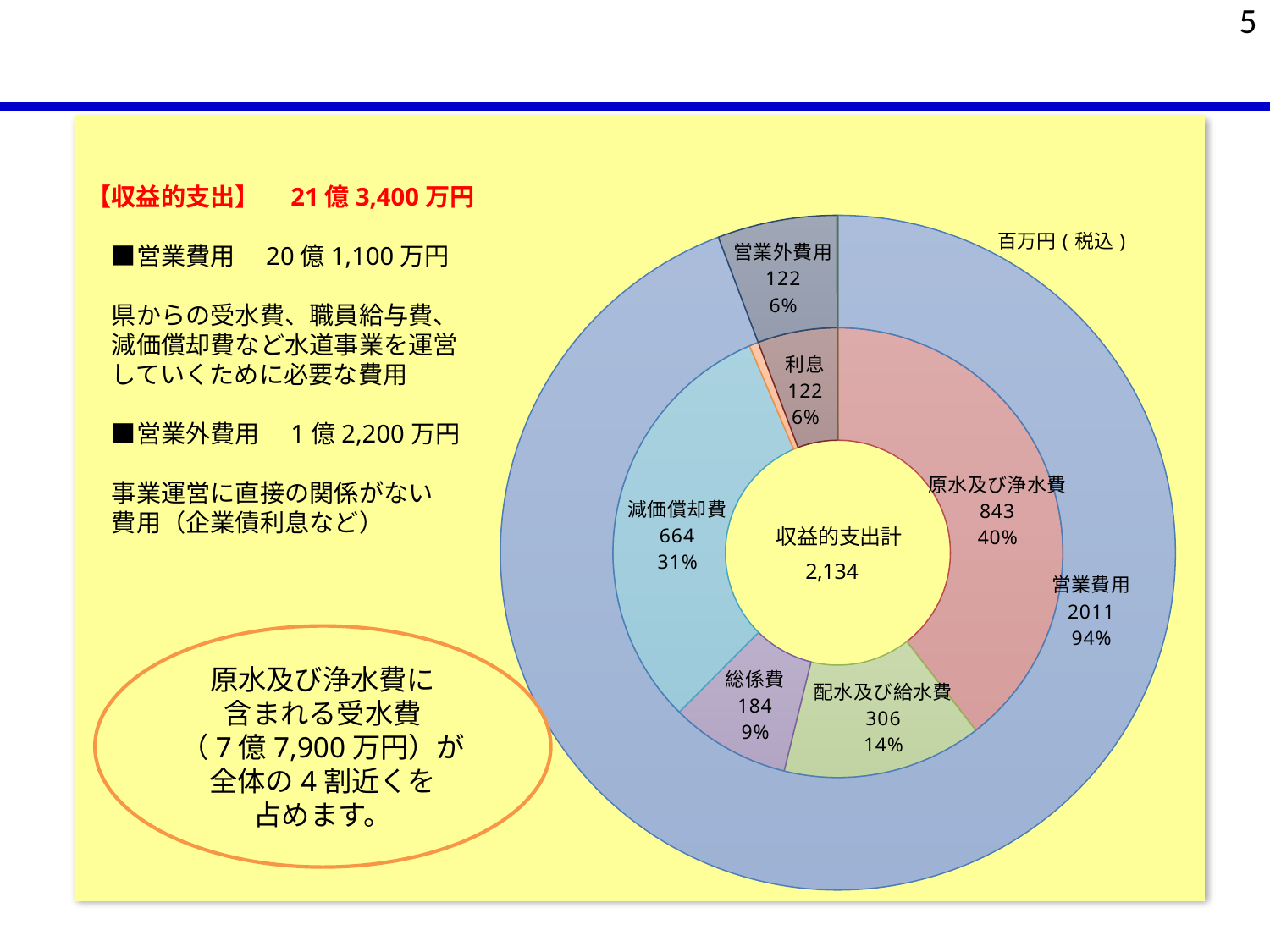
What percentage is shown for 減価償却費? 31% What percentage is shown for 営業外費用 in the outer ring? 6% What unit is stated in the top-right corner of the chart? 百万円（税込） What is the difference between the values for 原水及び浄水費 and 減価償却費? 179 What total is shown in the centre of the chart for 収益的支出計? 2,134 What is the value shown for 営業費用 in the outer ring? 2011 Which is larger, the value for 配水及び給水費 or the value for 総係費? 配水及び給水費 What is the value shown for 原水及び浄水費 in the inner ring? 843 Which segment of the inner ring has the largest value? 原水及び浄水費 What kind of chart is shown on the slide? Doughnut chart